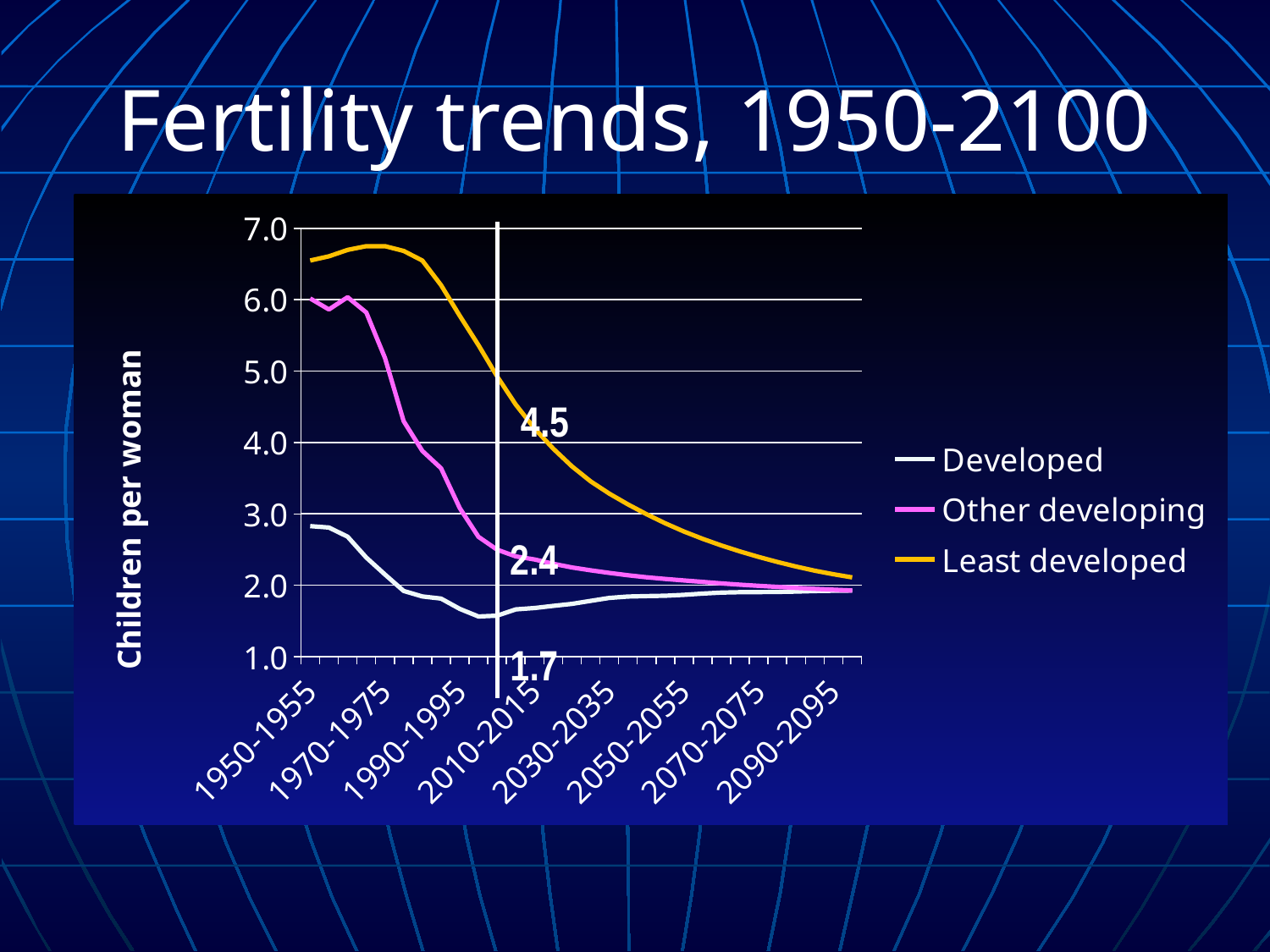
Does the Least developed line rise or fall from 1970-1975 to 2090-2095? fall Is the value for Least developed in 1950-1955 greater or less than 6.0? greater What is the title of the y axis? Children per woman Which series has the highest value in 1950-1955? Least developed How many series does the legend list? 3 Is the value for Developed in 1950-1955 greater or less than 3.0? less What kind of chart is shown on the slide? line chart